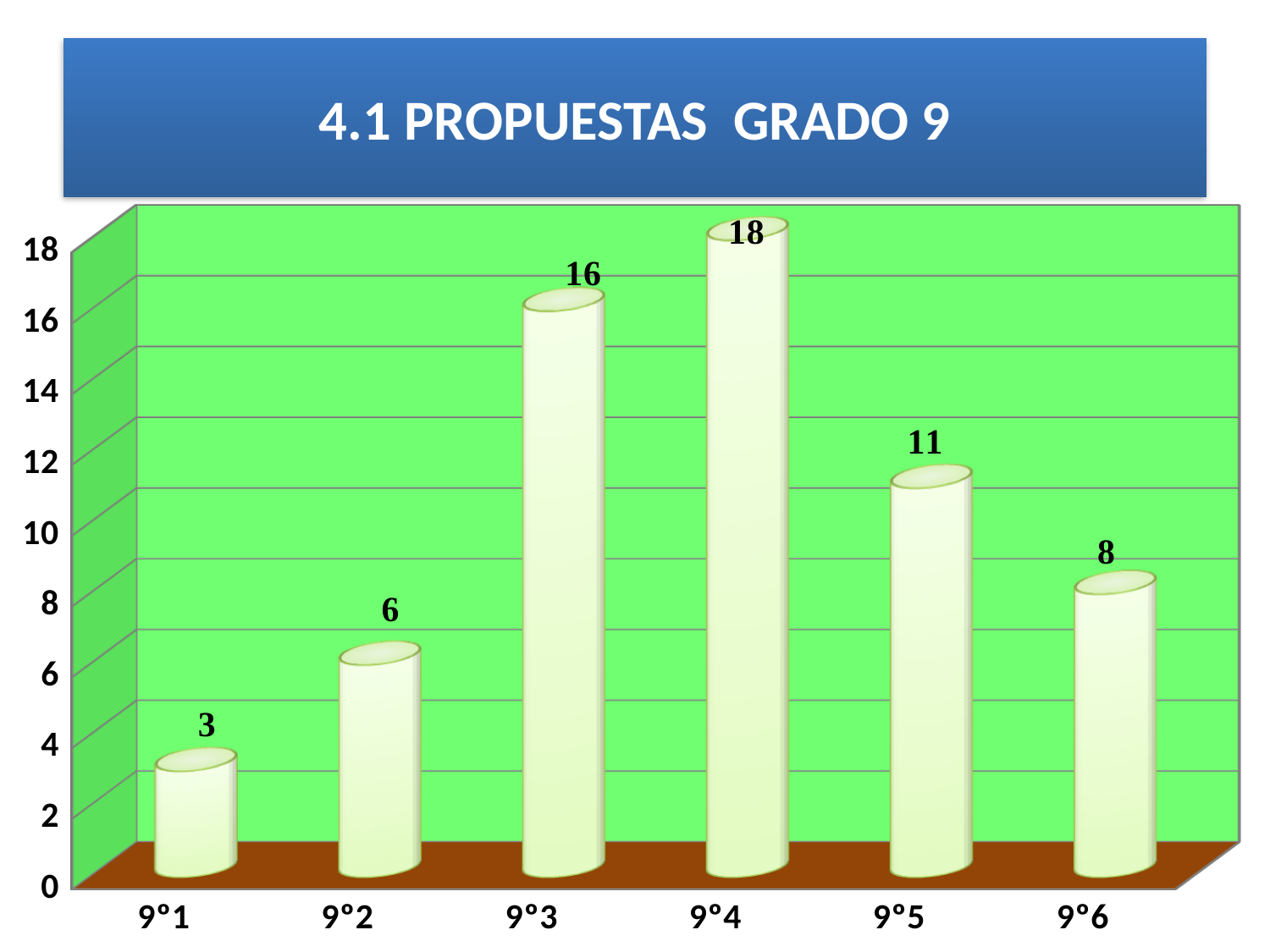
What is the value for 9°1? 3 Which is larger, the value for 9°5 or the value for 9°6? 9°5 What is the value for 9°5? 11 What kind of chart is shown on the slide? bar chart What is the difference between the values for 9°3 and 9°2? 10 Do the values rise or fall from 9°4 to 9°6? fall Which category has the lowest value? 9°1 What is the title of the slide? 4.1 PROPUESTAS GRADO 9 How many categories are shown on the x axis? 6 What is the value for 9°4? 18 Which category has the highest value? 9°4 Is the value for 9°3 greater or less than 14? greater